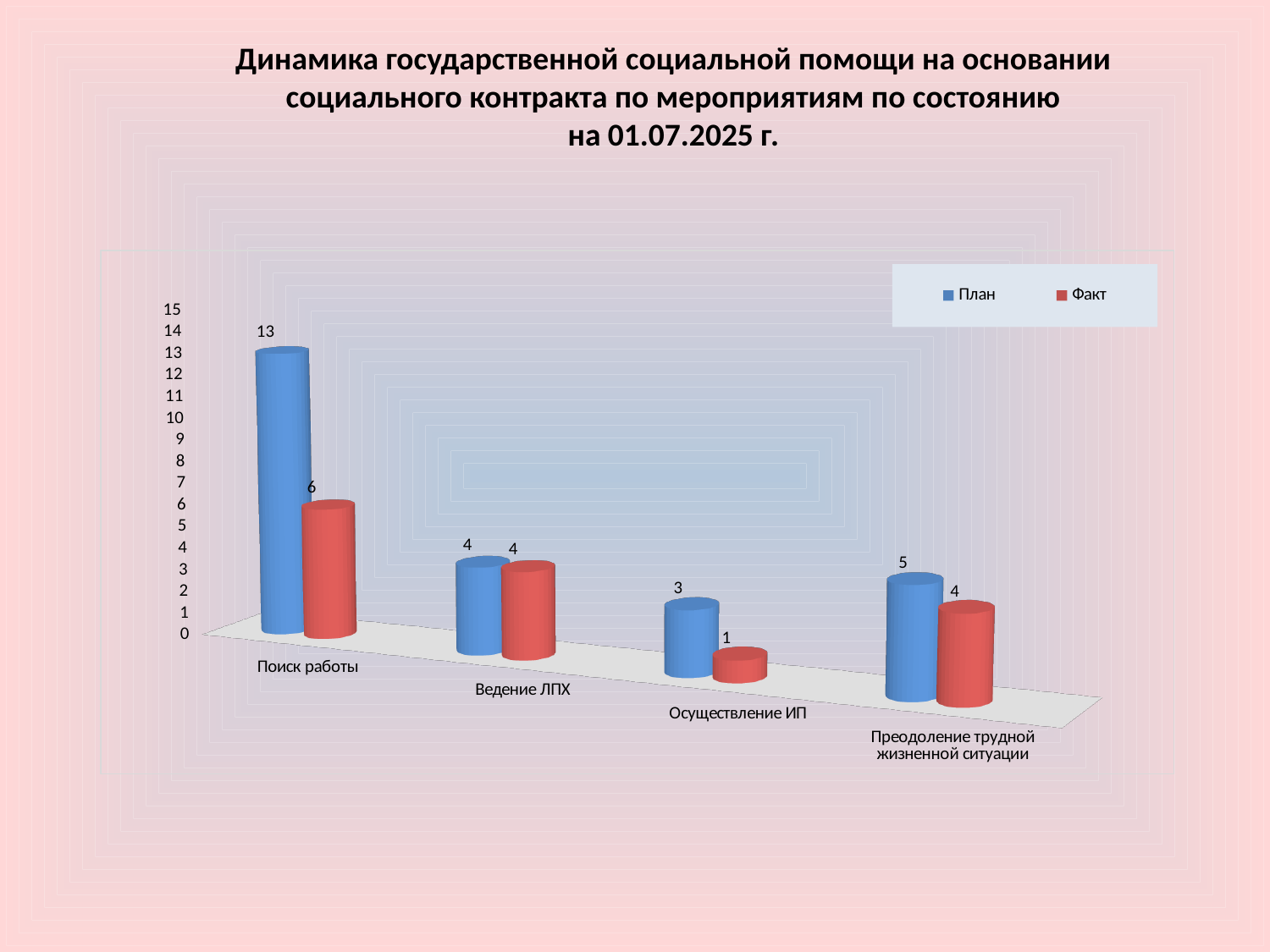
How many series does the legend list? 2 What is the Факт value for Поиск работы? 6 Which series is shown in red in the legend? Факт What is the difference between the План and Факт values for Поиск работы? 7 Which category has the lowest Факт value? Осуществление ИП Which is larger for Осуществление ИП, the План value or the Факт value? План What kind of chart is shown on the slide? Bar chart How many categories are shown on the x axis? 4 What is the План value for Преодоление трудной жизненной ситуации? 5 Which category has the highest План value? Поиск работы What is the План value for Поиск работы? 13 What is the Факт value for Осуществление ИП? 1